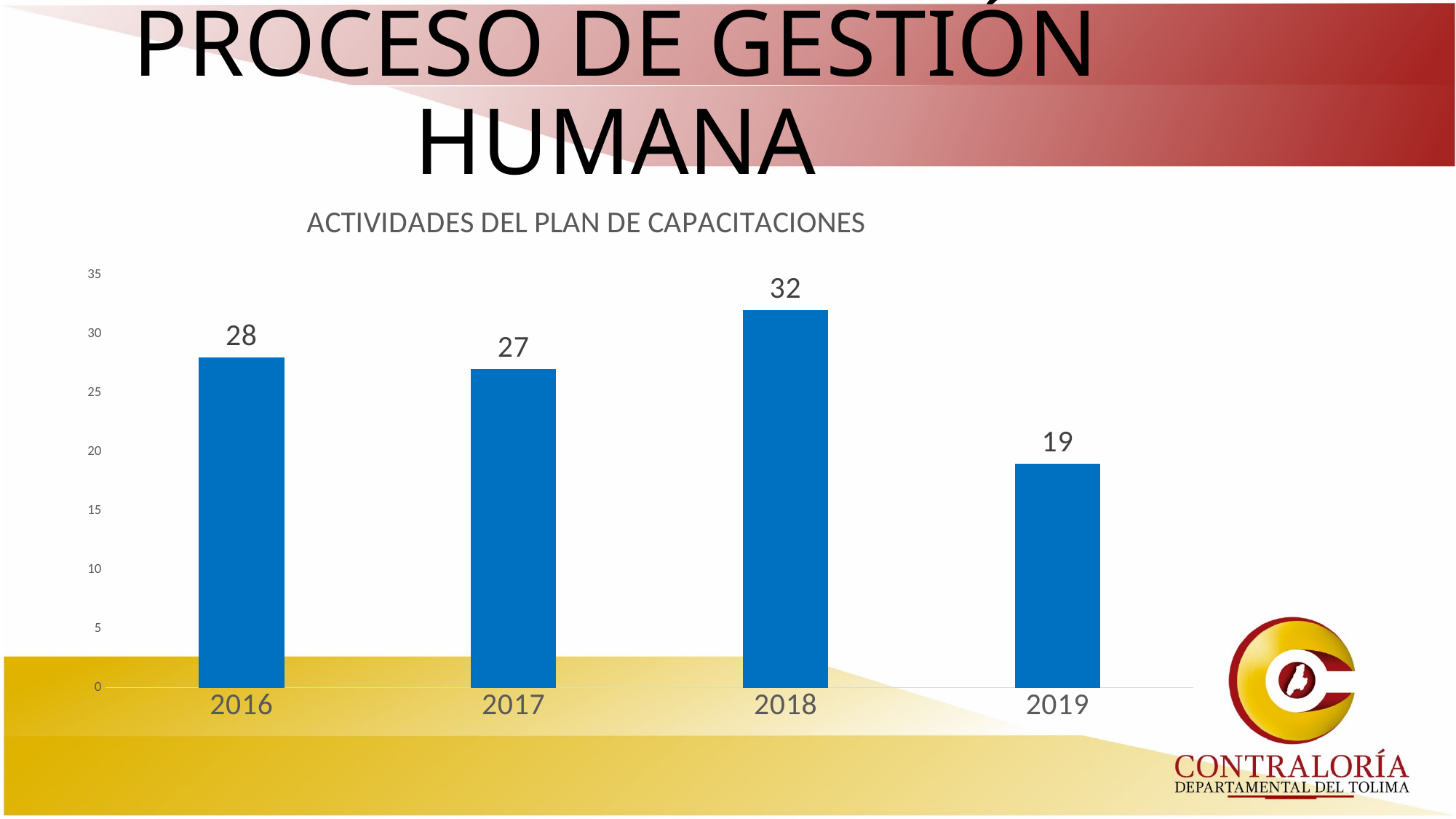
Which year has the highest value? 2018 What is the title of the chart? ACTIVIDADES DEL PLAN DE CAPACITACIONES What is the value for 2018? 32 How many years are shown on the x axis? 4 What is the value for 2017? 27 What kind of chart is shown on the slide? bar chart Which year has the lowest value? 2019 Which is larger, the value for 2016 or the value for 2017? 2016 Is the value for 2019 greater or less than 20? less What is the value for 2016? 28 What is the difference between the values for 2018 and 2019? 13 What is the value for 2019? 19